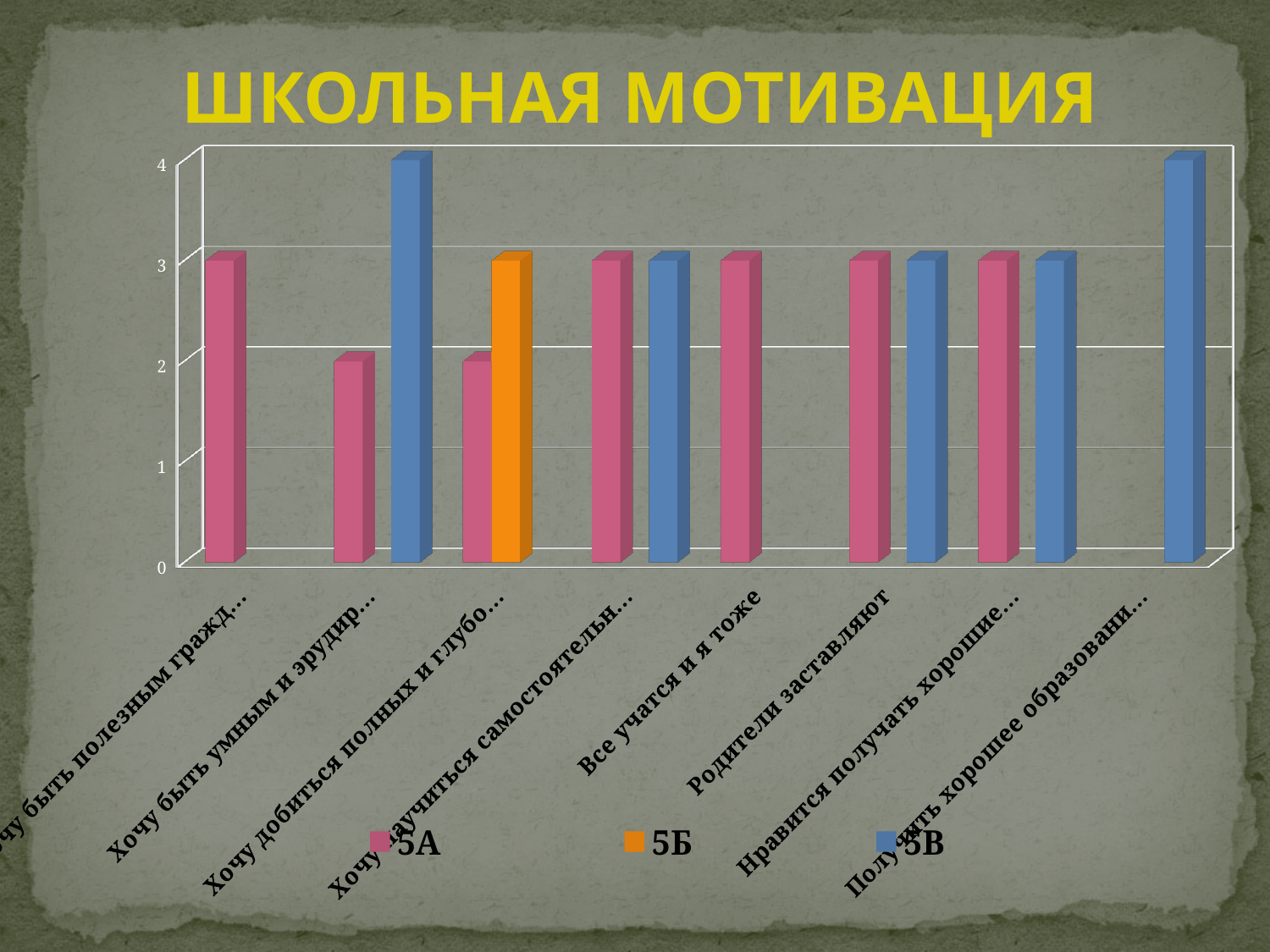
Is the value for 5В in the category "Получить хорошее образовани..." greater or less than 3? greater What is the value for 5В in the category "Родители заставляют"? 3 In the category "Хочу быть умным и эрудир...", which is larger, the value for 5А or for 5В? 5В What is the value for 5А in the category "Все учатся и я тоже"? 3 What is the title of the slide? ШКОЛЬНАЯ МОТИВАЦИЯ What kind of chart is shown on the slide? bar chart In how many categories does the 5Б series have a bar? 1 How many categories are shown on the x axis? 8 What is the difference between the 5В and 5А values in the category "Хочу быть умным и эрудир..."? 2 What is the value for 5А in the category "Родители заставляют"? 3 What are the legend entries of the chart? 5А, 5Б, 5В How many series does the legend list? 3